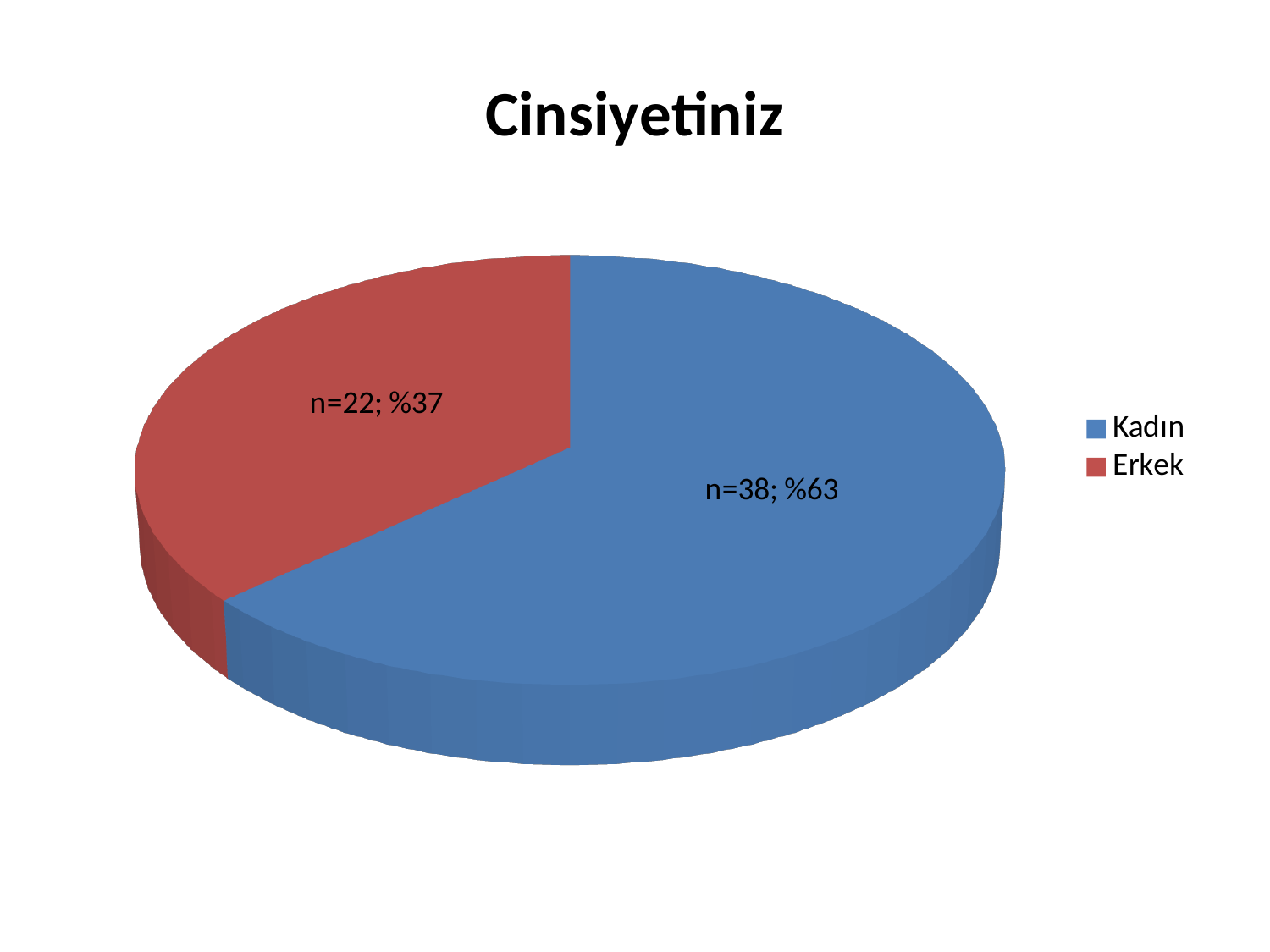
What is the count (n) for Kadın? n=38 What share of the pie does Erkek represent? %37 What is the difference in count between Kadın and Erkek? 16 How many slices does the pie chart have? 2 What is the title of the chart? Cinsiyetiniz What is the count (n) for Erkek? n=22 What kind of chart is shown on the slide? pie chart Which colour represents Erkek in the chart? red What share of the pie does Kadın represent? %63 How many entries does the legend list? 2 Which category has the smallest slice? Erkek Which category has the largest slice? Kadın